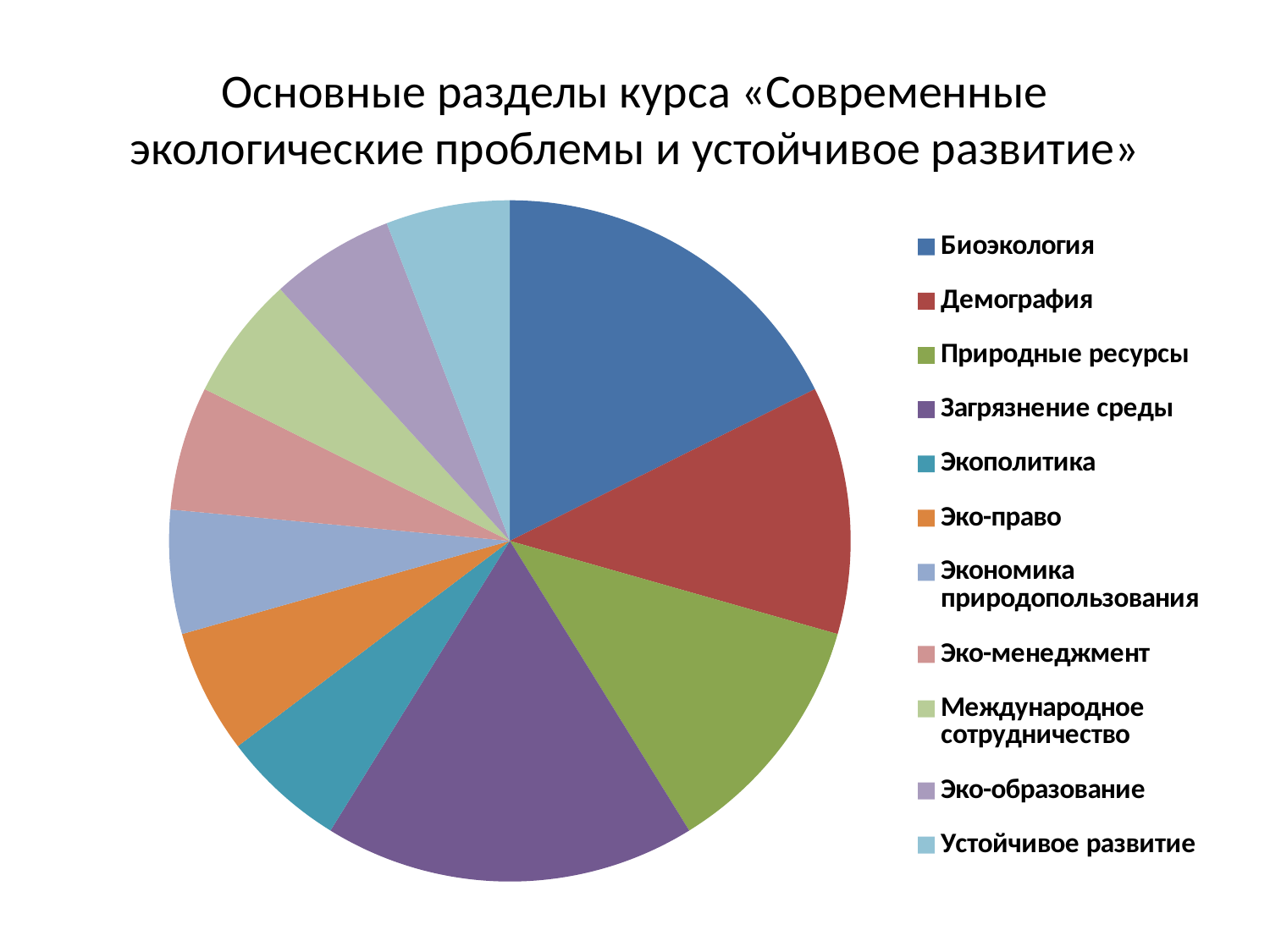
Which slice is larger, Биоэкология or Экополитика? Биоэкология Which slice is larger, Загрязнение среды or Эко-образование? Загрязнение среды Which slice is larger, Загрязнение среды or Устойчивое развитие? Загрязнение среды How many entries does the legend of the pie chart list? 11 How many slices does the pie chart have? 11 What is the title of the slide containing the pie chart? Основные разделы курса «Современные экологические проблемы и устойчивое развитие» What kind of chart is shown on the slide? pie chart What colour is the Биоэкология slice in the pie chart? blue